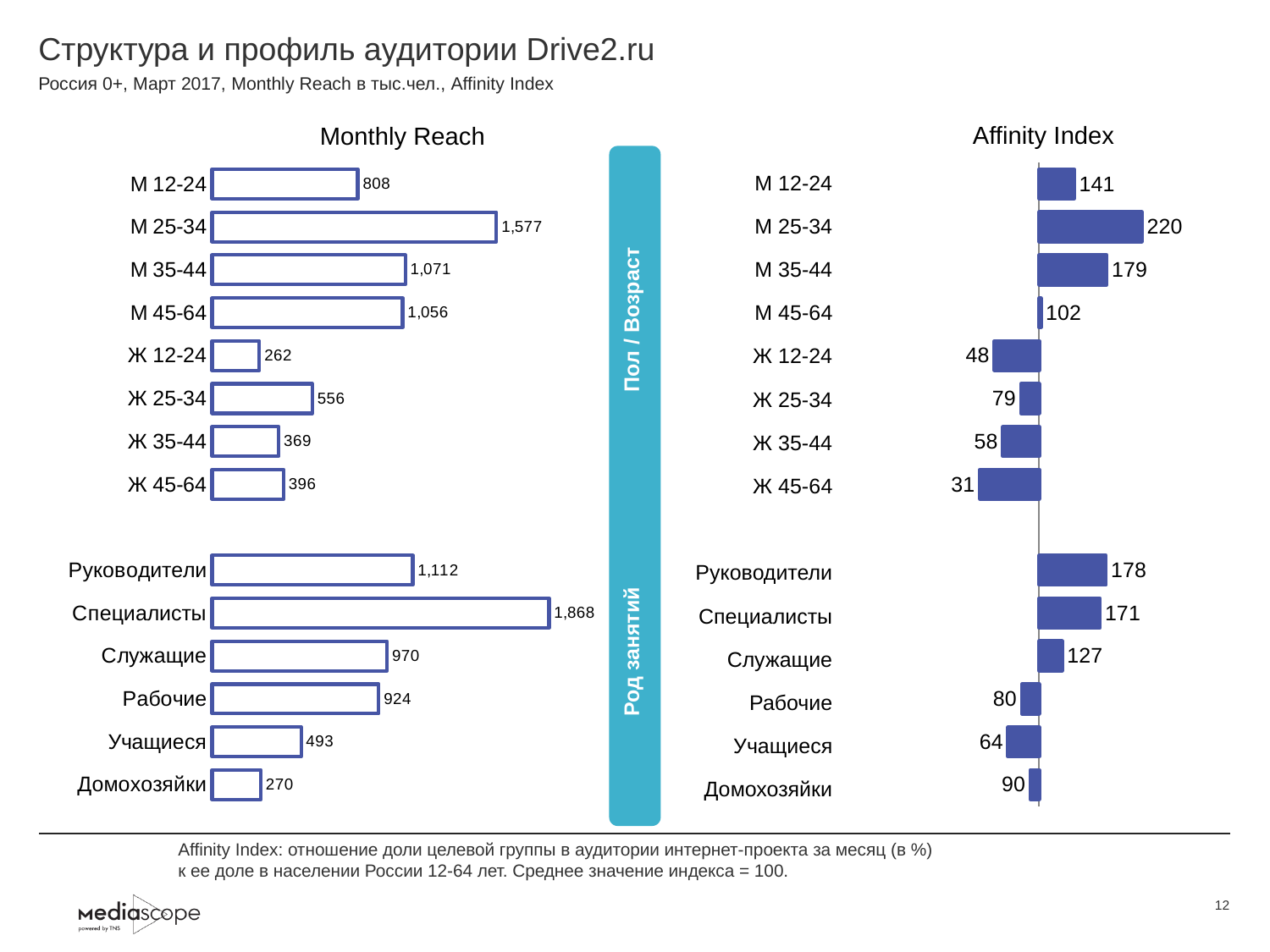
In the Affinity Index chart, what is the difference between М 35-44 and М 45-64? 77 In the Monthly Reach chart, what is the value for Домохозяйки? 270 In the Affinity Index chart, what is the value for Ж 45-64? 31 How many categories are plotted in the Monthly Reach chart? 14 In the Monthly Reach chart, which is larger, Служащие or Рабочие? Служащие In the Monthly Reach chart, what is the difference between Специалисты and Руководители? 756 In the Affinity Index chart, which category has the highest value? М 25-34 What kind of chart is the Affinity Index chart? Bar chart In the Affinity Index chart, which category has the lowest value? Ж 45-64 In the Monthly Reach chart, which category has the highest value? Специалисты In the Monthly Reach chart, what is the value for М 25-34? 1,577 In the Affinity Index chart, which is larger, Учащиеся or Домохозяйки? Домохозяйки